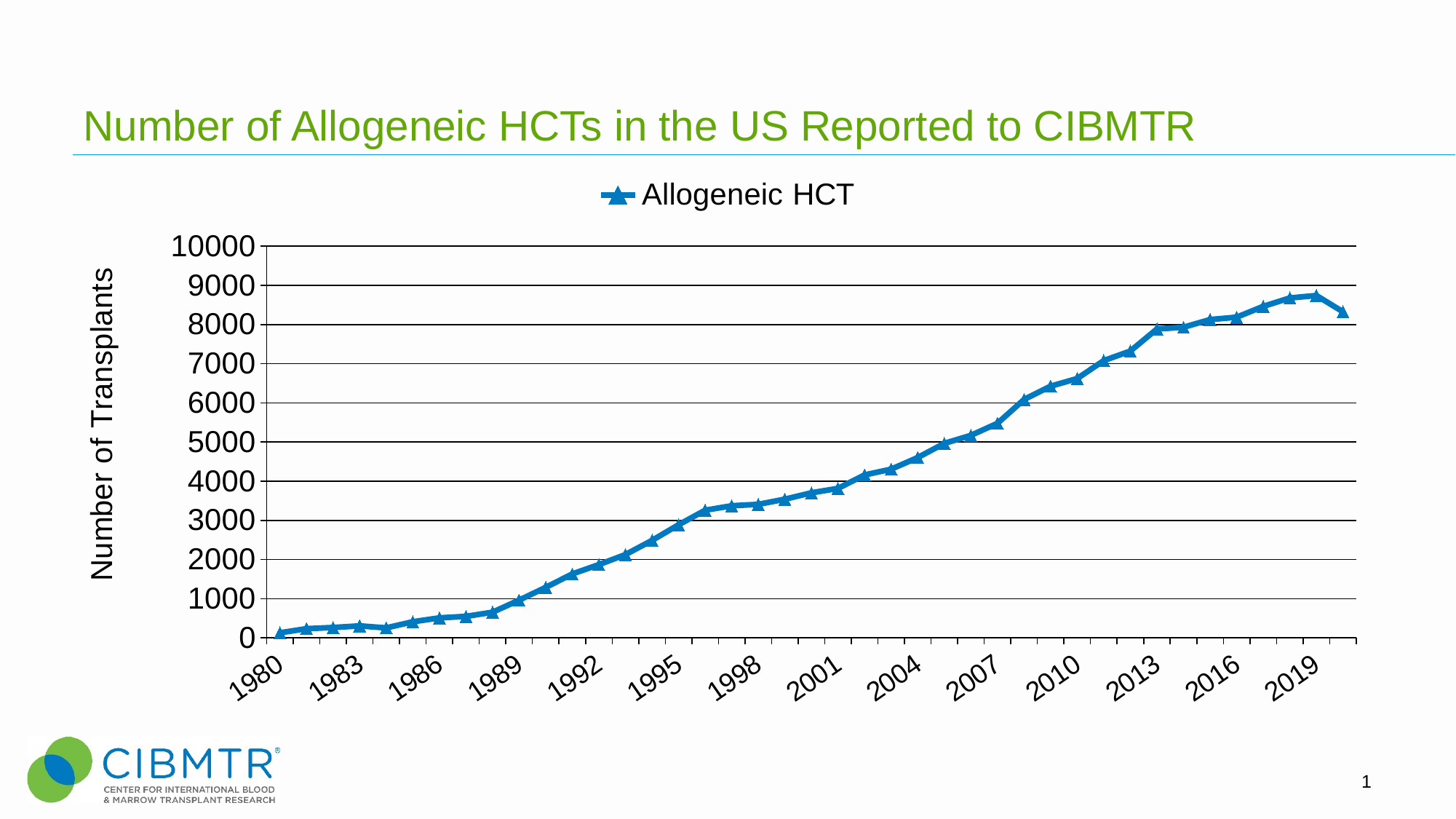
How many series does the legend list? 1 Which year has the lowest number of allogeneic HCTs? 1980 What is the title of the vertical axis? Number of Transplants Which year has the larger number of transplants, 1989 or 2007? 2007 Is the value for 2004 greater or less than 4000? greater What kind of chart is shown on the slide? line chart Overall, do the values rise or fall from 1980 to 2019? rise Is the value for 2010 greater or less than 6000? greater What is the name of the series shown in the legend? Allogeneic HCT Is the value for 1980 greater or less than 1000? less